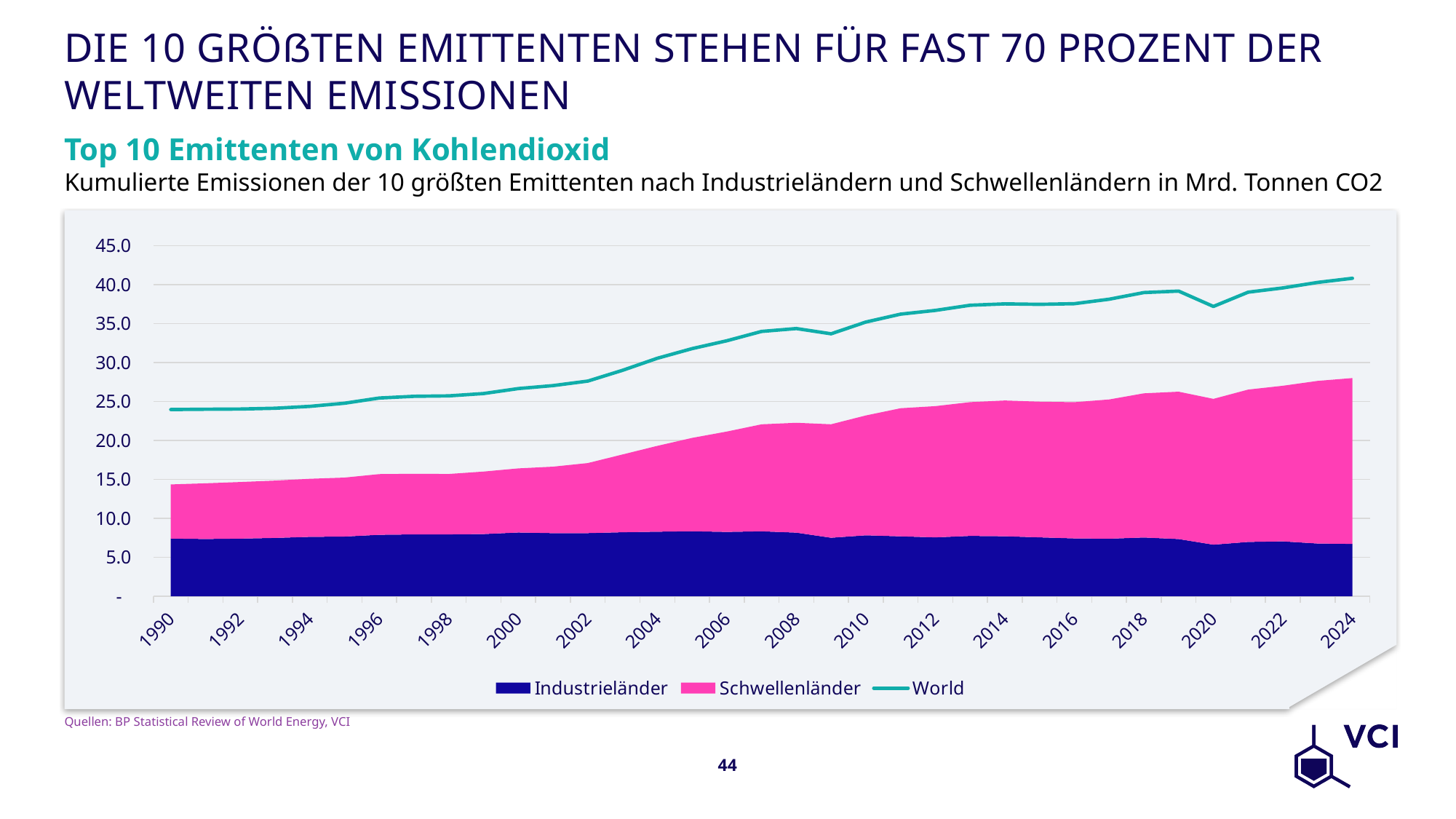
Is the World value for 2000 greater or less than 25.0? greater How many series does the legend list? 3 What kind of chart is shown on the slide? Stacked area chart with a line What is the title of the chart? Top 10 Emittenten von Kohlendioxid Is the World value for 2020 greater or less than 40.0? less How many years are labelled on the x axis? 18 Which series are listed in the legend? Industrieländer, Schwellenländer, World Which is larger, the World value for 2019 or for 2020? 2019 In which year does the World line reach its highest value? 2024 Is the Industrieländer value for 2024 greater or less than 10.0? less Does the World line rise or fall from 1990 to 2024? Rises